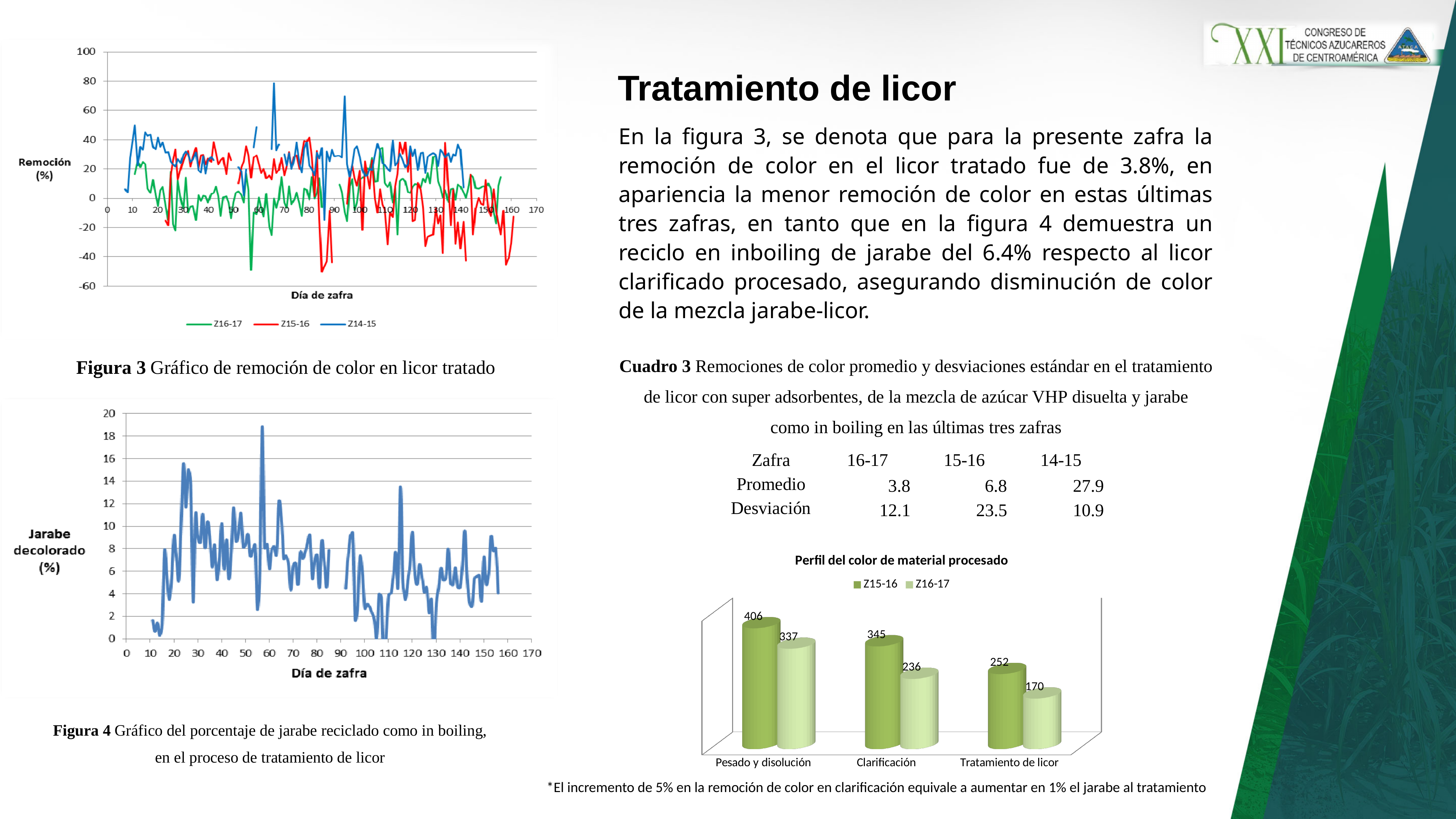
In the chart titled 'Perfil del color de material procesado', what is the difference between the Z15-16 and Z16-17 values for 'Clarificación'? 109 In the chart titled 'Perfil del color de material procesado', how many categories are shown on the x axis? 3 In the chart titled 'Perfil del color de material procesado', what is the value for Z16-17 in the 'Clarificación' category? 236 In the chart of Figura 3 (top left), how many series does the legend list? 3 In the chart titled 'Perfil del color de material procesado', which category has the highest value for Z15-16? Pesado y disolución What is the x-axis label of the chart in Figura 4 (bottom left)? Día de zafra In the chart titled 'Perfil del color de material procesado', which category has the lowest value for Z16-17? Tratamiento de licor What kind of chart is the one titled 'Perfil del color de material procesado'? Bar chart In the chart titled 'Perfil del color de material procesado', how many series does the legend list? 2 In the chart titled 'Perfil del color de material procesado', what is the value for Z15-16 in the 'Pesado y disolución' category? 406 In the chart titled 'Perfil del color de material procesado', what is the value for Z16-17 in the 'Tratamiento de licor' category? 170 In the chart titled 'Perfil del color de material procesado', which is larger: the Z15-16 value for 'Tratamiento de licor' or the Z16-17 value for 'Pesado y disolución'? Z16-17 value for Pesado y disolución